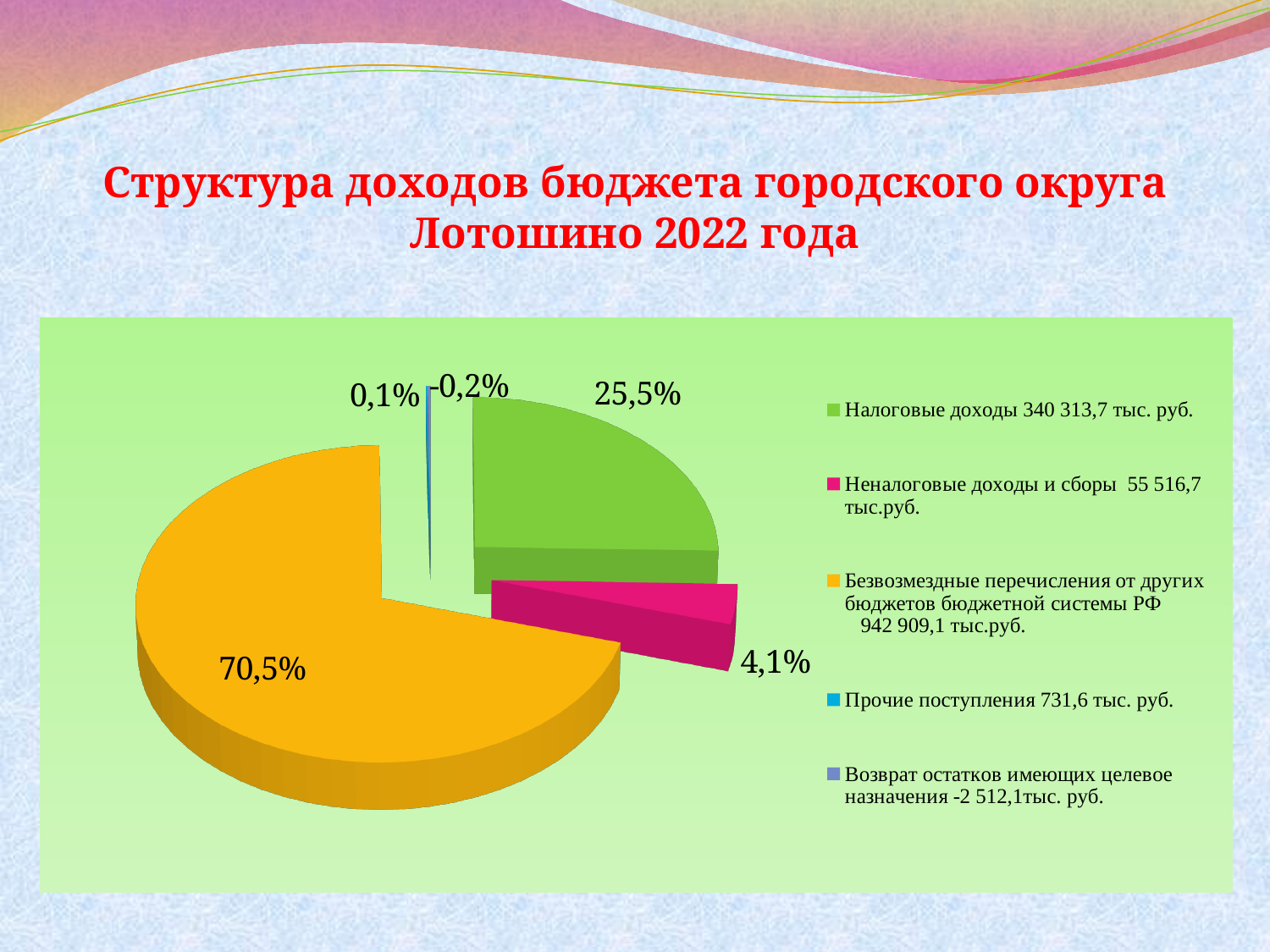
What share of the pie is labelled for Налоговые доходы? 25,5% What is the smallest percentage label shown on the pie? 0,1% What kind of chart is shown on the slide? pie chart What share of the pie is labelled for Безвозмездные перечисления от других бюджетов бюджетной системы РФ? 70,5% What share of the pie is labelled for Неналоговые доходы и сборы? 4,1% What amount does the legend give for Налоговые доходы? 340 313,7 тыс. руб. What amount does the legend give for Прочие поступления? 731,6 тыс. руб. What is the difference in percentage points between the Налоговые доходы slice and the Неналоговые доходы и сборы slice? 21,4% Which category has the largest slice of the pie? Безвозмездные перечисления от других бюджетов бюджетной системы РФ Which slice is larger: Налоговые доходы or Неналоговые доходы и сборы? Налоговые доходы How many categories does the pie chart have? 5 What is the difference in percentage points between the Безвозмездные перечисления slice and the Налоговые доходы slice? 45%